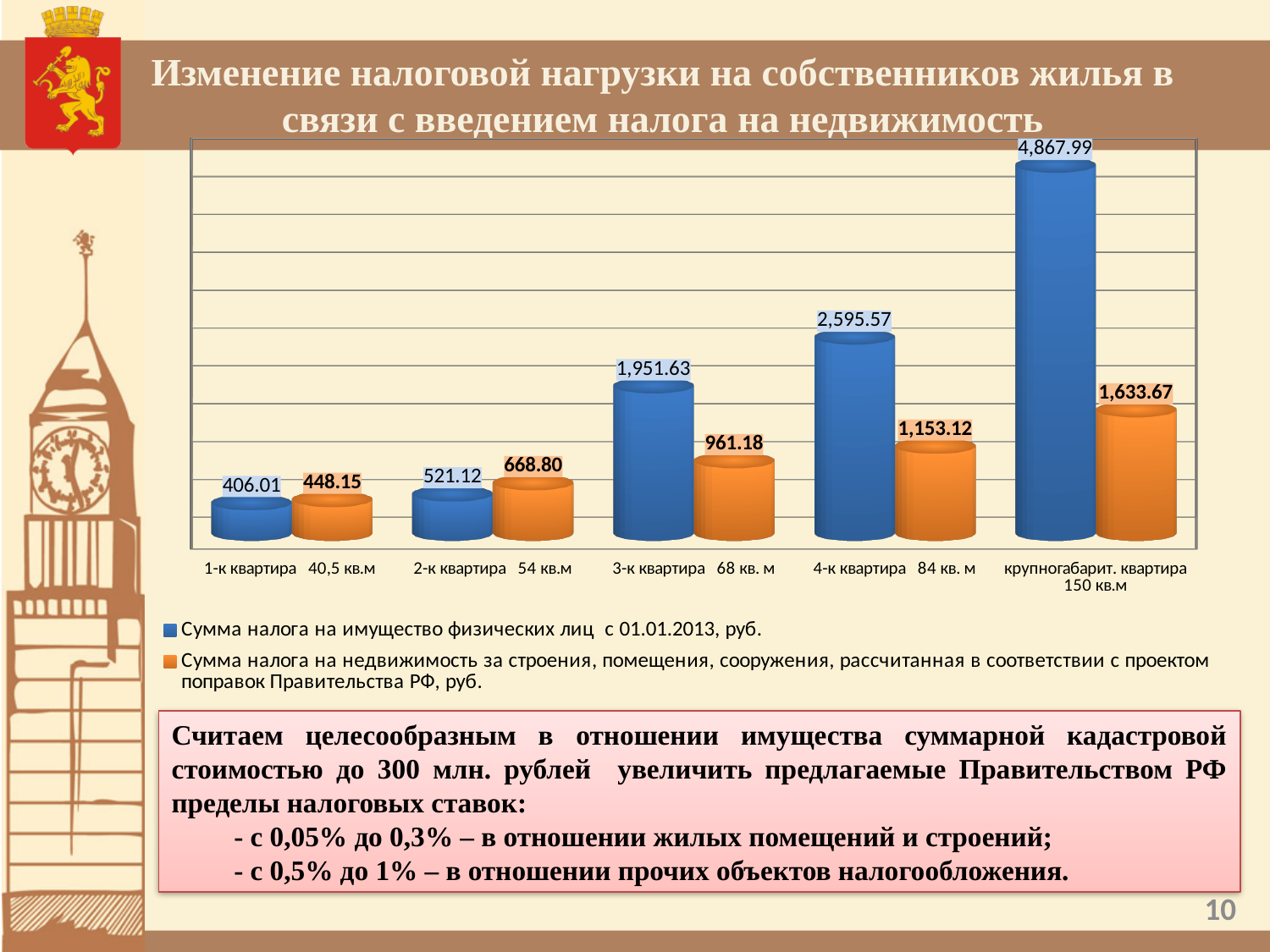
How many categories are shown on the x axis of the chart? 5 Do the values of the blue series rise or fall from left to right along the x axis? rise What is the value of the orange series (налог на недвижимость по проекту поправок Правительства РФ) for 2-к квартира 54 кв.м? 668.80 For 4-к квартира 84 кв. м, which is larger: the blue series value or the orange series value? the blue series (2,595.57) Which category has the highest value in the blue series? крупногабарит. квартира 150 кв.м Which category has the lowest value in the orange series? 1-к квартира 40,5 кв.м What is the difference between the orange and blue values for 1-к квартира 40,5 кв.м? 42.14 What kind of chart is shown on the slide? bar chart What is the value of the blue series (Сумма налога на имущество физических лиц с 01.01.2013) for 3-к квартира 68 кв. м? 1,951.63 What is the value of the orange series for крупногабарит. квартира 150 кв.м? 1,633.67 What is the difference between the blue and orange values for крупногабарит. квартира 150 кв.м? 3,234.32 How many series does the legend list? 2